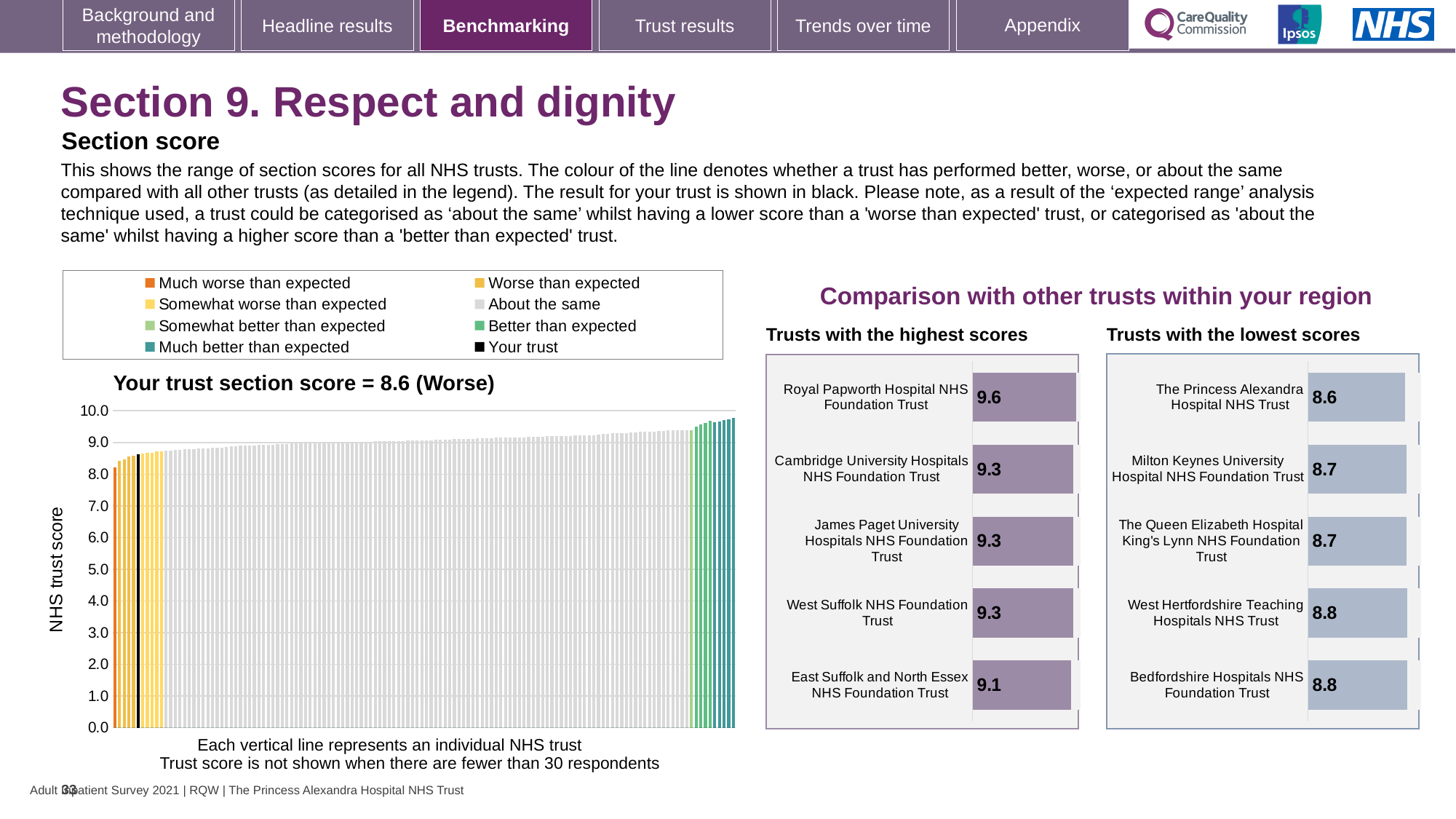
In the 'Trusts with the highest scores' chart, what is the score for Royal Papworth Hospital NHS Foundation Trust? 9.6 In the 'Your trust section score' chart, how is your trust's score categorised, as shown in the chart title? Worse In the 'Trusts with the highest scores' chart, which trust has the highest score? Royal Papworth Hospital NHS Foundation Trust In the 'Trusts with the lowest scores' chart, which has the larger score: The Princess Alexandra Hospital NHS Trust or Bedfordshire Hospitals NHS Foundation Trust? Bedfordshire Hospitals NHS Foundation Trust In the 'Your trust section score' chart, what is the section score for your trust? 8.6 How many trusts are shown in the 'Trusts with the lowest scores' chart? 5 In the 'Trusts with the highest scores' chart, which trust has the lowest score? East Suffolk and North Essex NHS Foundation Trust What kind of chart is the 'Your trust section score' chart? Bar chart How many entries does the legend above the 'Your trust section score' chart list? 8 In the 'Your trust section score' chart, do the trust scores rise or fall from left to right along the x axis? Rise In the 'Trusts with the lowest scores' chart, what is the score for West Hertfordshire Teaching Hospitals NHS Trust? 8.8 In the 'Trusts with the highest scores' chart, what is the difference between the scores of Royal Papworth Hospital NHS Foundation Trust and East Suffolk and North Essex NHS Foundation Trust? 0.5